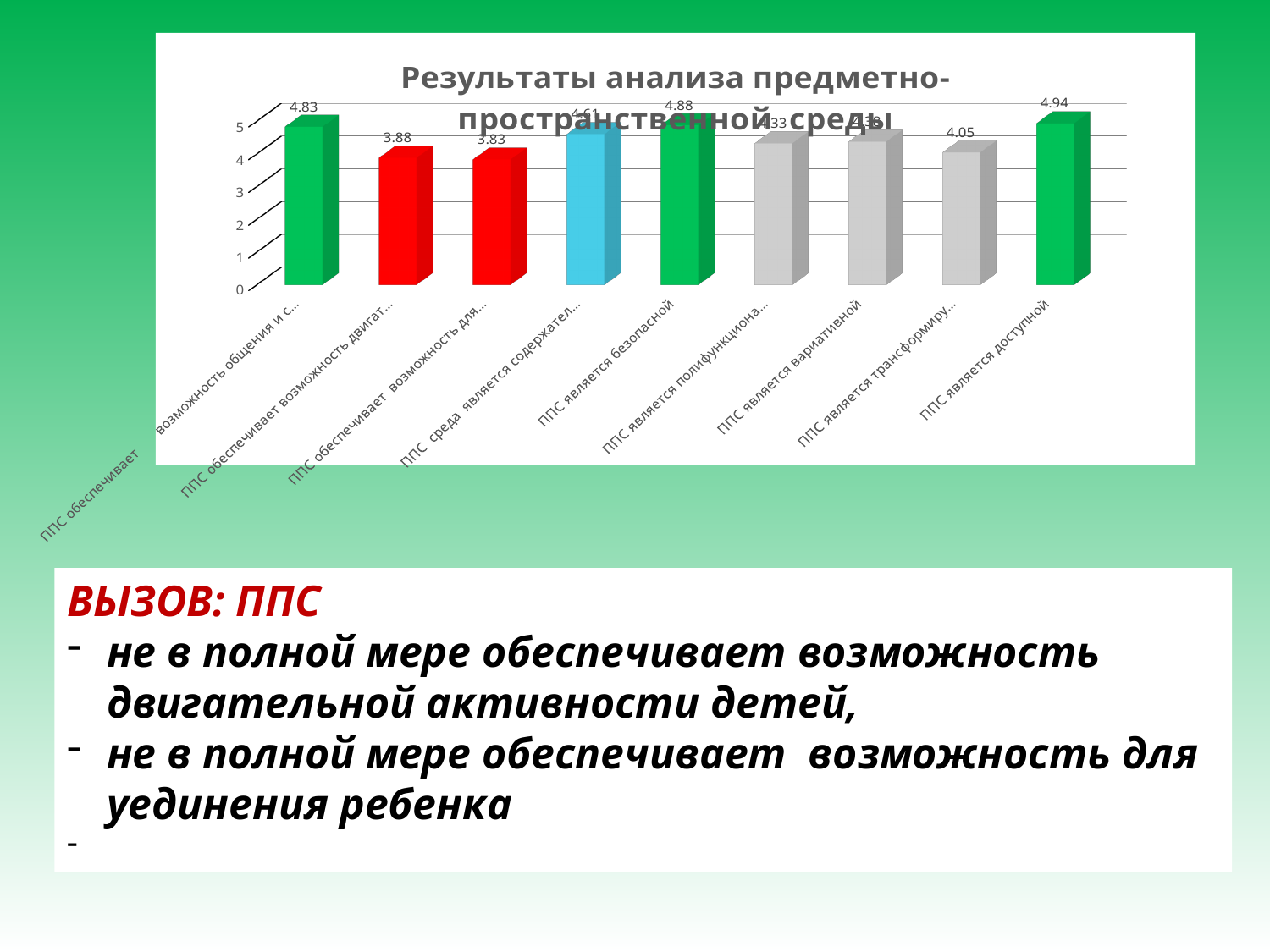
Which is larger: the value for "ППС является безопасной" or for "ППС является доступной"? ППС является доступной What is the title of the chart? Результаты анализа предметно-пространственной среды How many bars (categories) does the chart show? 9 What type of chart is shown on the slide? bar chart What is the lowest value shown in the chart? 3.83 Is the value for "ППС является вариативной" greater or less than 4? greater What is the value for "ППС является доступной"? 4.94 What colour is the bar for "ППС является доступной"? green Which category has the highest value in the chart? ППС является доступной What is the difference between the values for "ППС является доступной" and "ППС является безопасной"? 0.06 What is the value for "ППС является безопасной"? 4.88 How many bars in the chart are red? 2